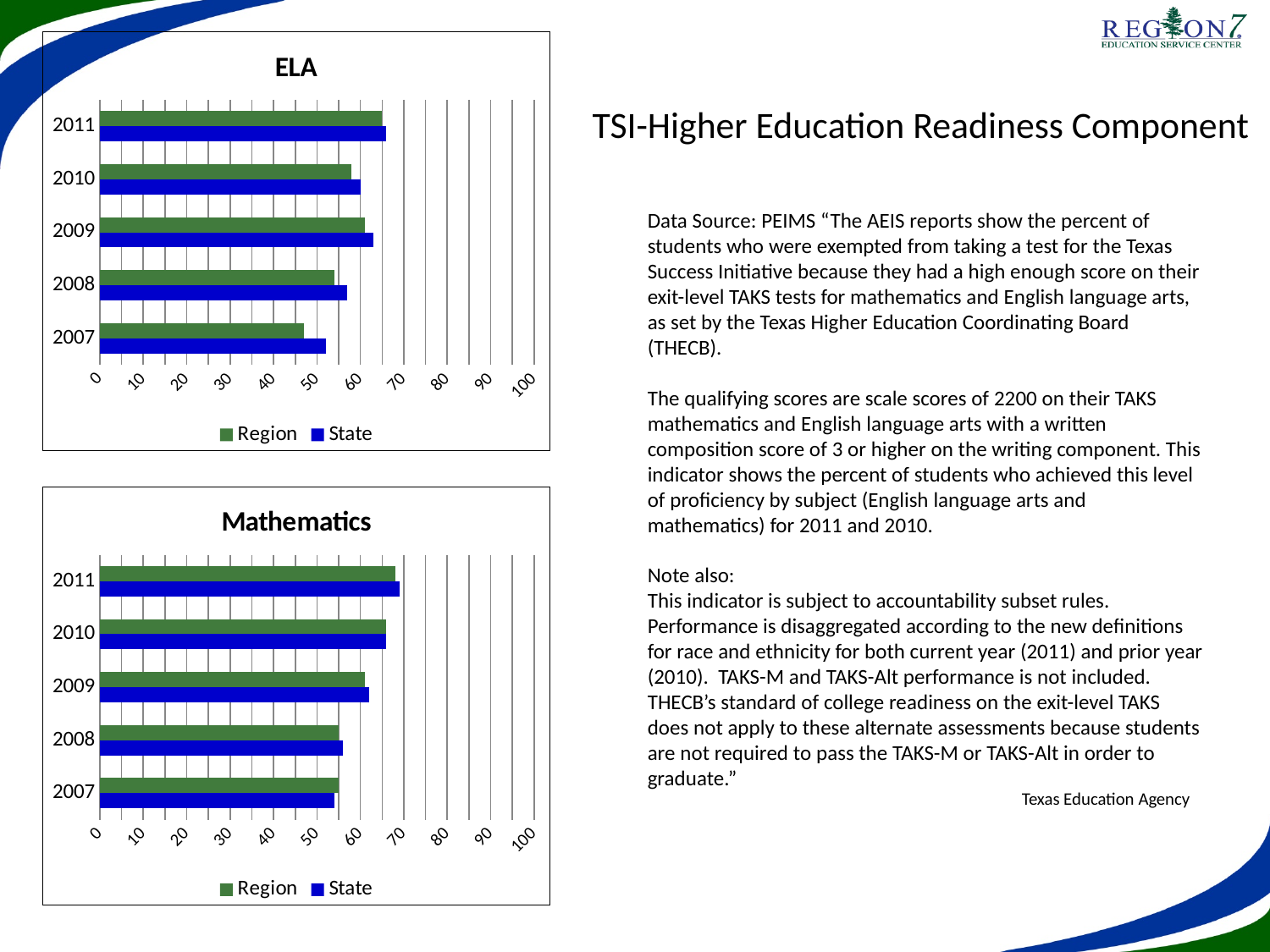
In the ELA chart, which year has the highest Region value? 2011 In the ELA chart, which year has the lowest Region value? 2007 In the Mathematics chart, is the Region value for 2007 greater or less than 50? greater How many series does the legend of the Mathematics chart list? 2 In the ELA chart, is the Region value for 2007 greater or less than 50? less In the ELA chart, for 2007, which is larger: the Region value or the State value? State In the Mathematics chart, which year has the highest State value? 2011 In the ELA chart, is the State value for 2011 greater or less than 60? greater What type of chart is the ELA chart? bar chart What are the two series named in the legend of the ELA chart? Region and State How many years are shown on the ELA chart? 5